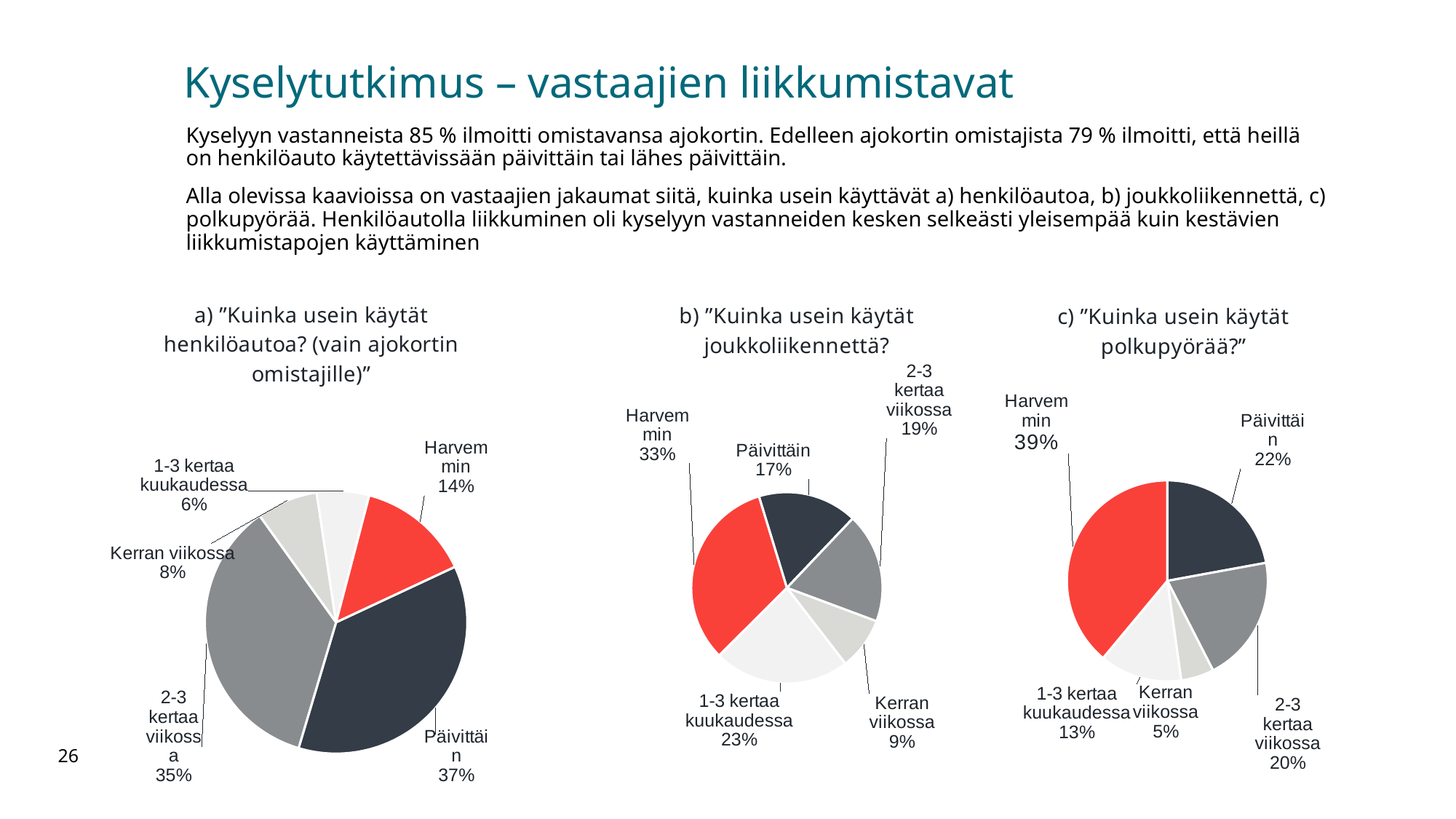
In chart b) "Kuinka usein käytät joukkoliikennettä?", which is larger: 1-3 kertaa kuukaudessa or Päivittäin? 1-3 kertaa kuukaudessa What type of chart is chart c) "Kuinka usein käytät polkupyörää?"? Pie chart In chart a) "Kuinka usein käytät henkilöautoa?", what share of respondents answered Päivittäin? 37% In chart c) "Kuinka usein käytät polkupyörää?", what share of respondents answered 1-3 kertaa kuukaudessa? 13% In chart b) "Kuinka usein käytät joukkoliikennettä?", what share of respondents answered Harvemmin? 33% How many slices does chart b) "Kuinka usein käytät joukkoliikennettä?" have? 5 In chart a) "Kuinka usein käytät henkilöautoa?", what is the difference in percentage points between Päivittäin and Harvemmin? 23 percentage points In chart a) "Kuinka usein käytät henkilöautoa?", which category has the smallest share? 1-3 kertaa kuukaudessa In chart b) "Kuinka usein käytät joukkoliikennettä?", which category has the smallest share? Kerran viikossa How many pie charts are shown on the slide? 3 In chart c) "Kuinka usein käytät polkupyörää?", which category has the largest share? Harvemmin In chart c) "Kuinka usein käytät polkupyörää?", which is larger: Päivittäin or 2-3 kertaa viikossa? Päivittäin